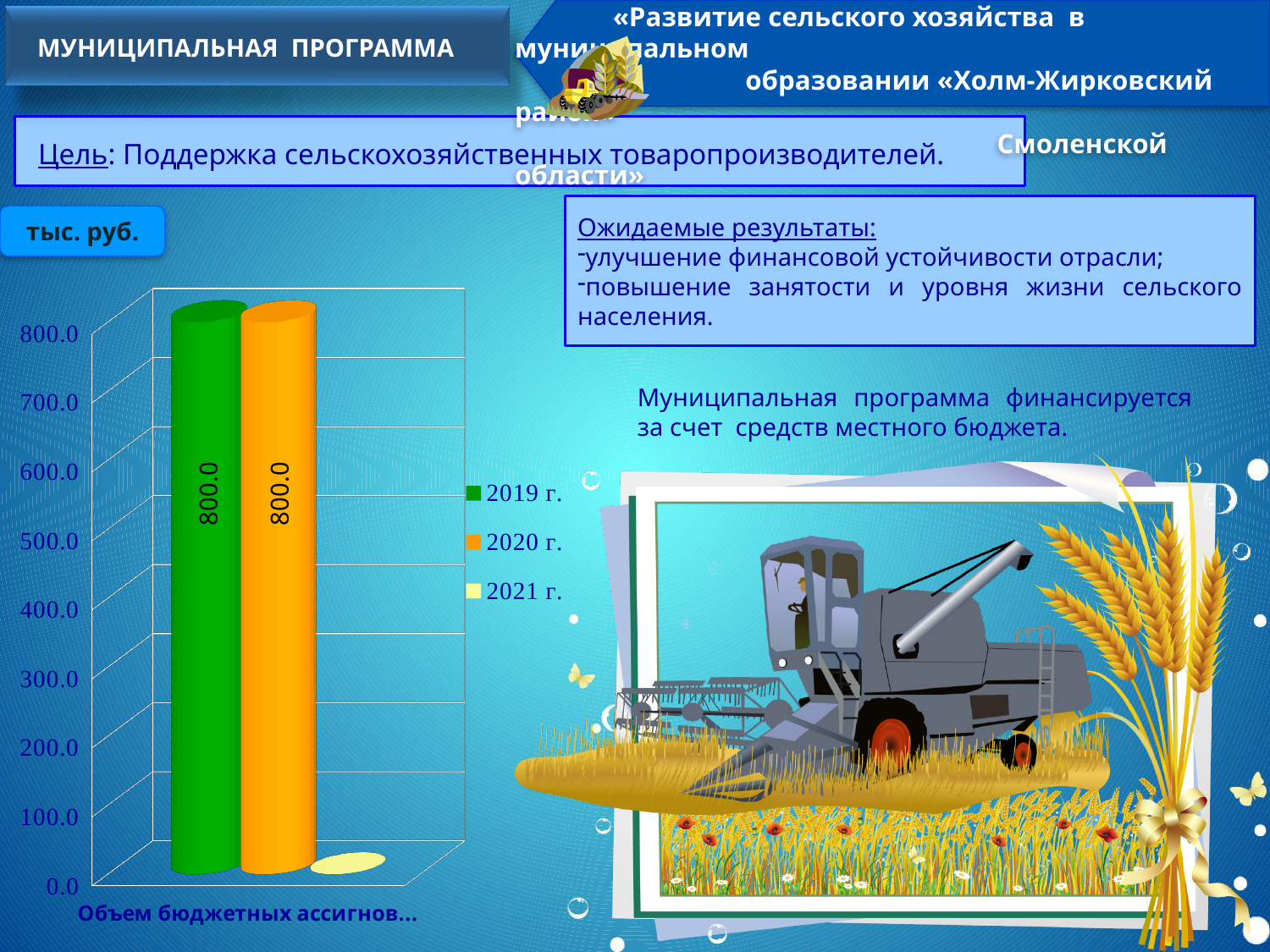
Is the value for 2020 г. larger than, smaller than, or equal to the value for 2019 г.? equal What is the highest tick value shown on the vertical axis? 800.0 What kind of chart is shown on the slide? bar chart How many series does the chart legend list? 3 Is the value for 2021 г. greater or less than 100.0? less What is the difference between the values for 2019 г. and 2020 г.? 0.0 What unit is indicated for the chart values? тыс. руб. What is the value for 2019 г. in the chart? 800.0 Is the value for 2019 г. greater or less than 700.0? greater Which series has the lowest value in the chart? 2021 г. What is the value for 2020 г. in the chart? 800.0 Which colour represents 2020 г. in the legend? orange